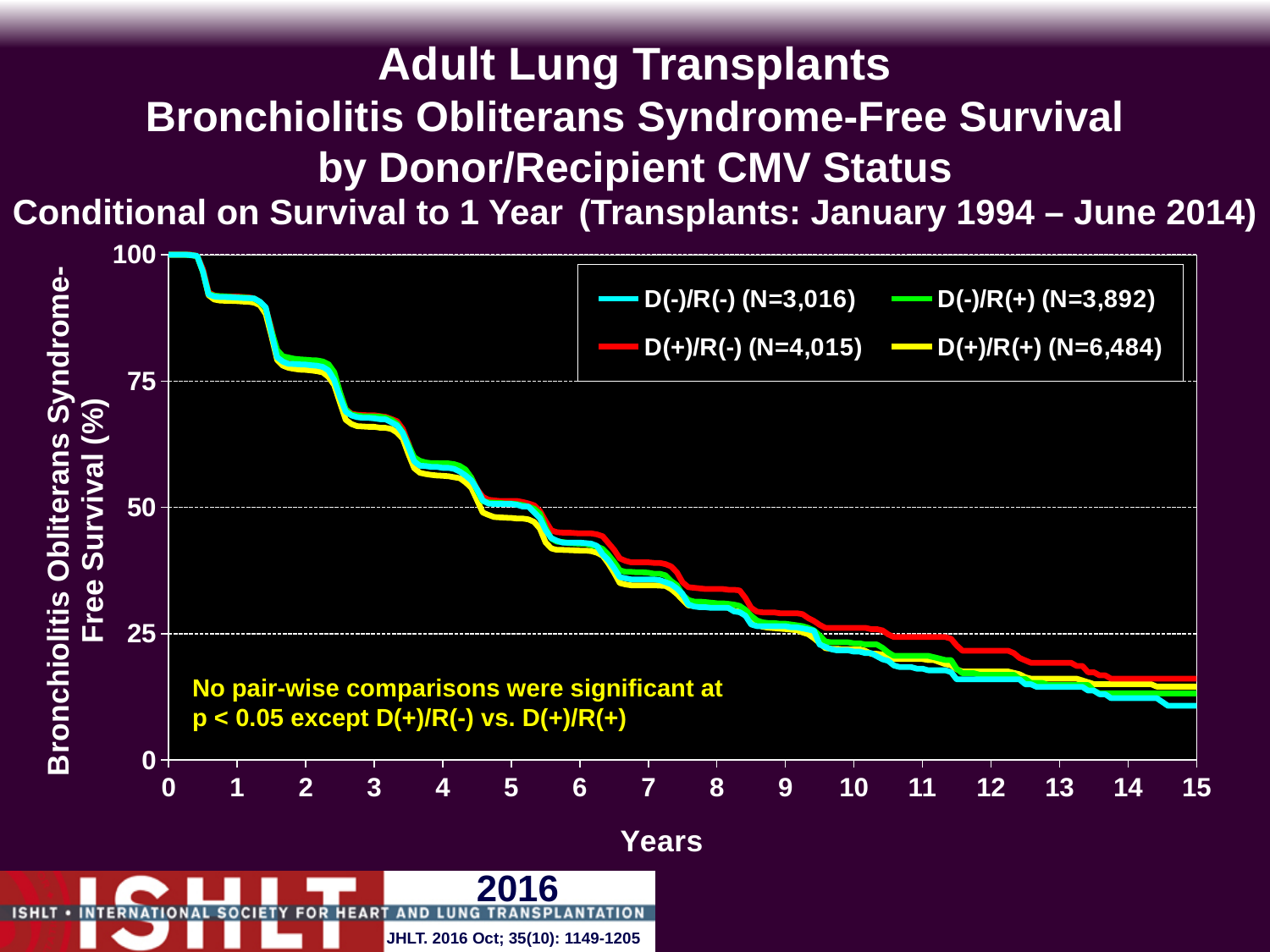
Which group has the lowest BOS-free survival at 15 years? D(-)/R(-) How many series does the legend list? 4 What is the N for the D(+)/R(+) group shown in the legend? N=6,484 Is the BOS-free survival for the D(+)/R(+) group at 7 years greater or less than 50? less Is the BOS-free survival for the D(-)/R(-) group at 1 year greater or less than 75? greater What kind of chart is shown on the slide? Line chart Which group has the highest BOS-free survival at 15 years? D(+)/R(-) Is the BOS-free survival for the D(+)/R(-) group at 3 years greater or less than 50? greater Which colour represents the D(+)/R(-) group? Red Do the survival curves rise or fall as years increase? Fall